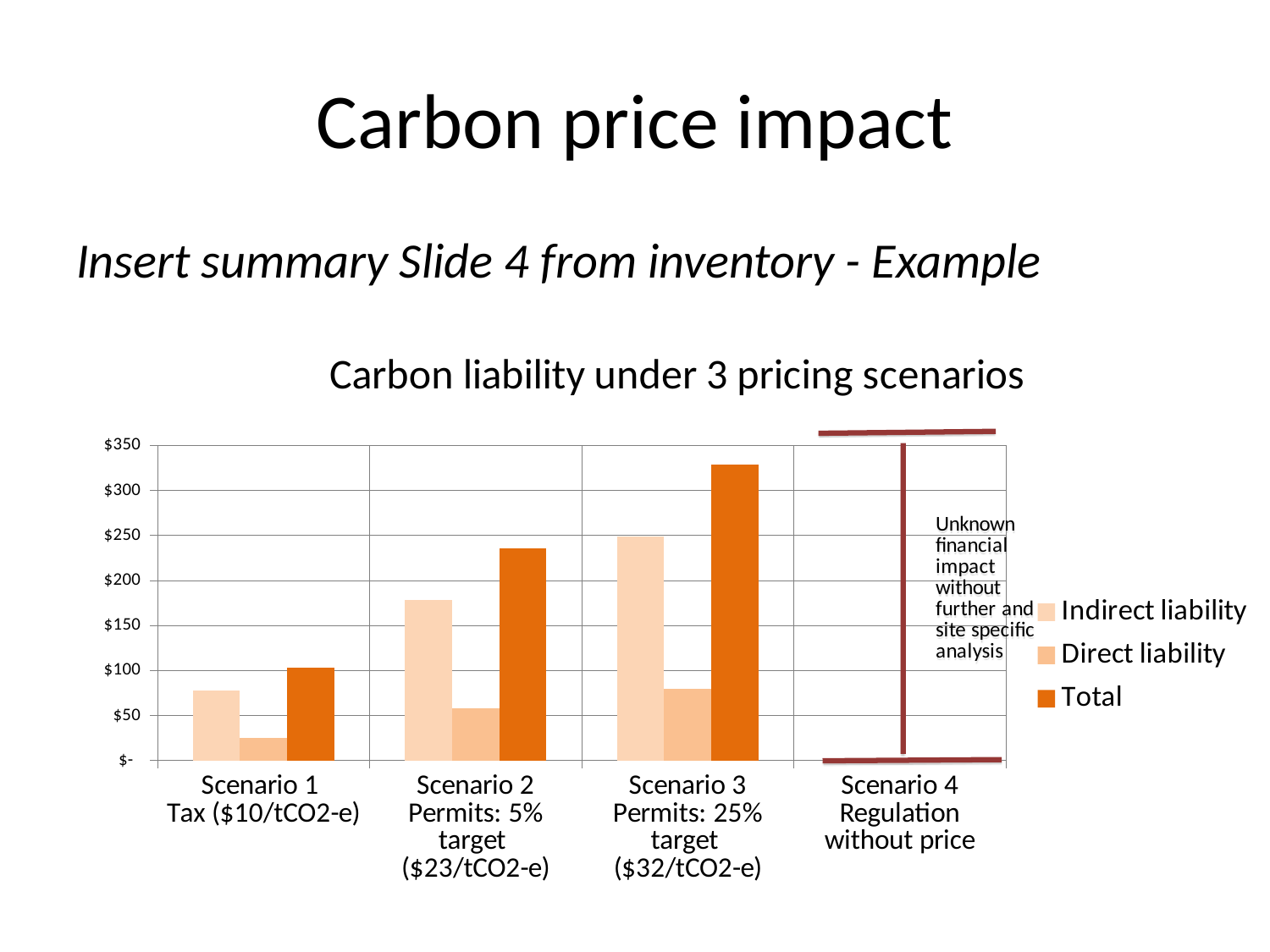
Which scenario has the highest Total bar? Scenario 3 Permits: 25% target ($32/tCO2-e) How many series does the legend list? 3 What kind of chart is shown on the slide? Bar chart What is the title of the chart? Carbon liability under 3 pricing scenarios Is the Total value for Scenario 3 greater or less than $300? greater Do the Total values rise or fall from Scenario 1 to Scenario 3? Rise Which is larger: the Indirect liability for Scenario 2 or the Direct liability for Scenario 3? Indirect liability for Scenario 2 Is the Total value for Scenario 2 greater or less than $200? greater Which scenario has the lowest Direct liability bar? Scenario 1 Tax ($10/tCO2-e) Is the Indirect liability value for Scenario 2 greater or less than $150? greater How many scenarios are labelled along the x axis? 4